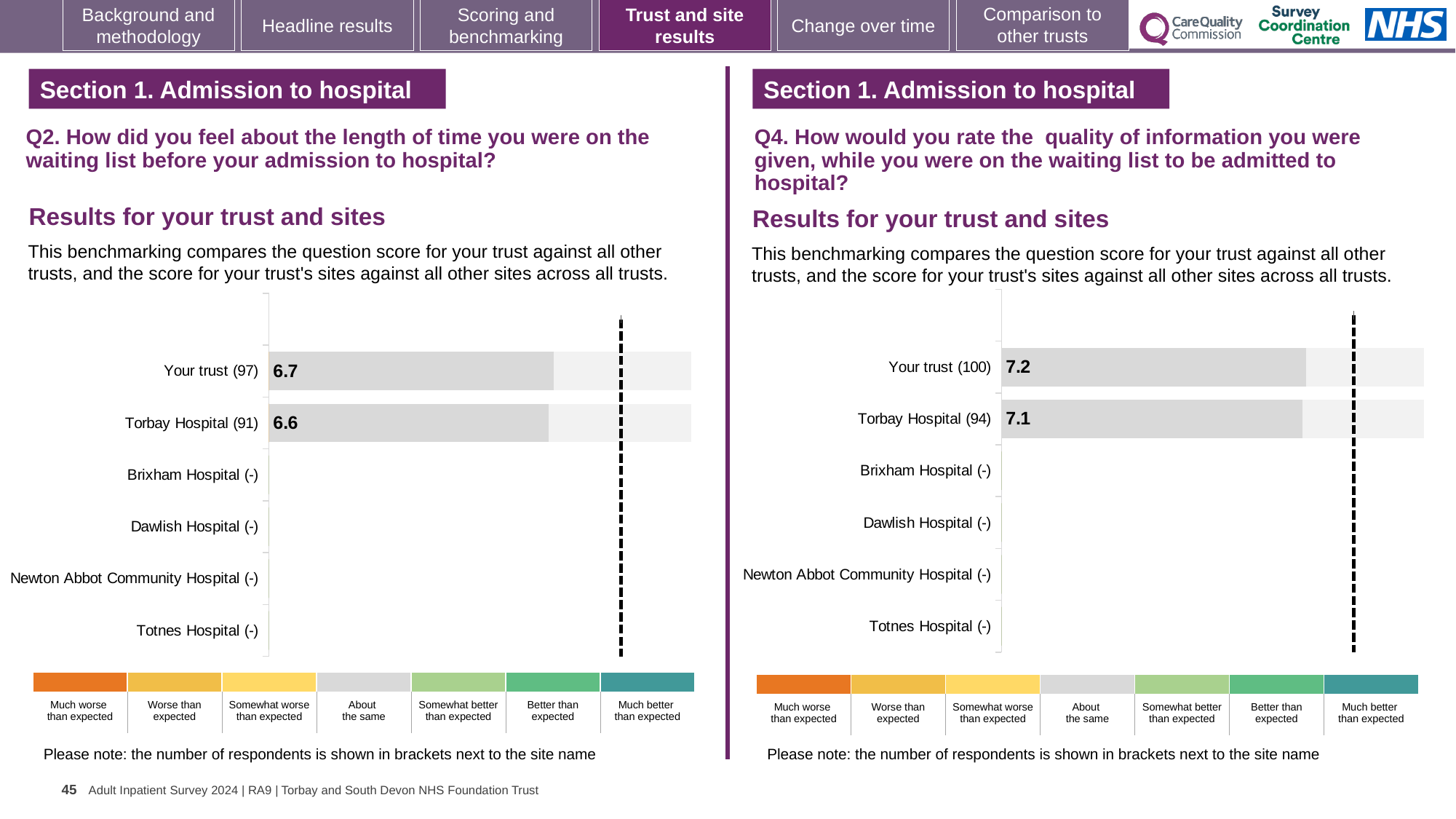
In the Q4 chart on the right, which category has the higher score, Your trust or Torbay Hospital? Your trust In the Q4 chart on the right, what is the score for Torbay Hospital? 7.1 In the Q4 chart on the right, what is the score for Your trust? 7.2 What kind of chart is used in the Q4 chart on the right? Bar chart In the Q2 chart on the left, how many respondents are shown in brackets for Your trust? 97 In the Q2 chart on the left, what is the difference between the Your trust score and the Torbay Hospital score? 0.1 In the Q2 chart on the left, what is the score for Your trust? 6.7 In the Q2 chart on the left, how many categories have a plotted bar with a score? 2 How many site/trust categories are listed on the y axis of the Q2 chart on the left? 6 In the Q2 chart on the left, what is the score for Torbay Hospital? 6.6 In the Q4 chart on the right, how many respondents are shown in brackets for Torbay Hospital? 94 In the Q4 chart on the right, what is the difference between the Your trust score and the Torbay Hospital score? 0.1